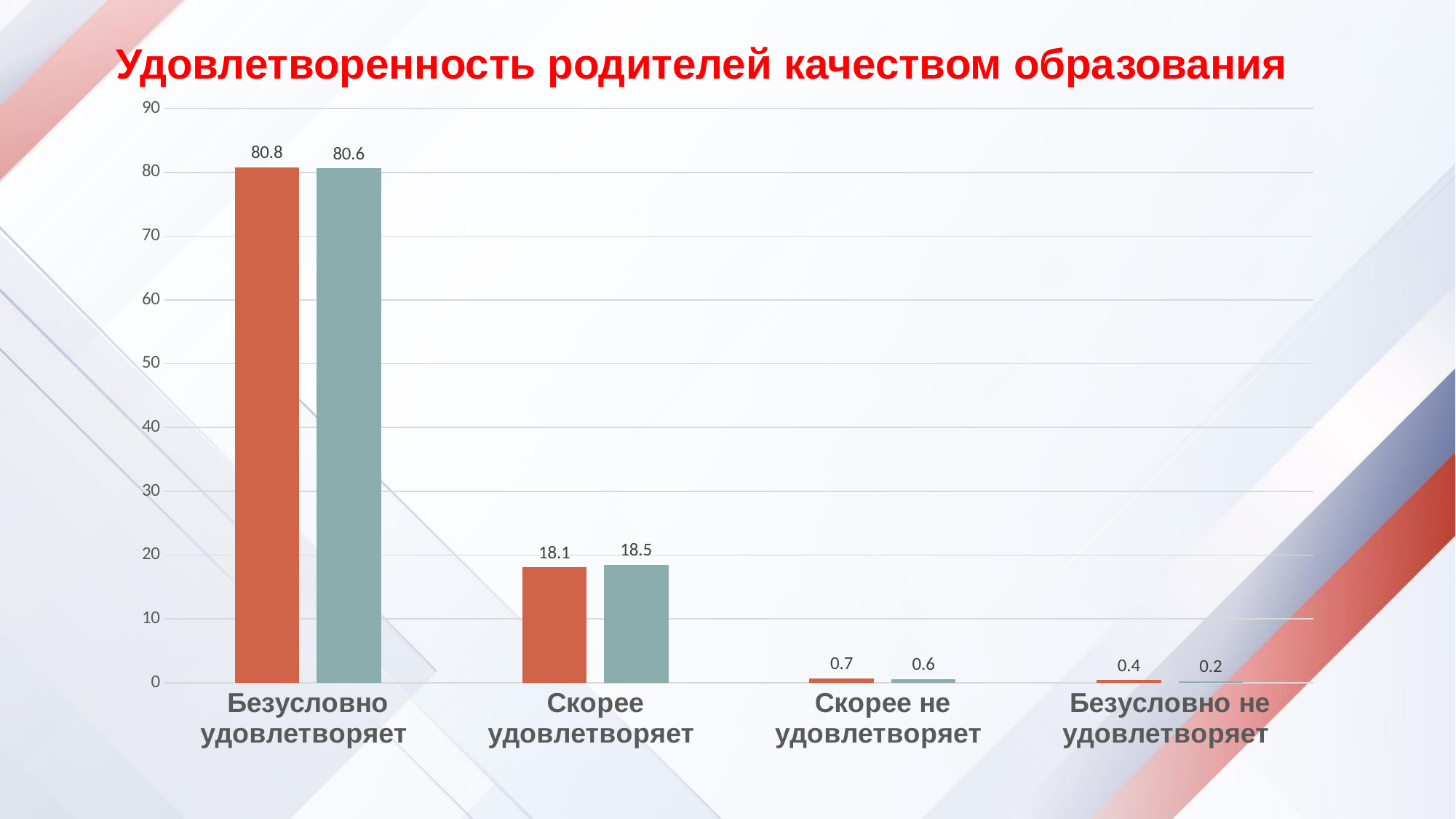
What is the difference between the grey bar (18.5) and the orange bar (18.1) for "Скорее удовлетворяет"? 0.4 How many categories are shown on the x axis? 4 What is the value of the grey bar for "Скорее не удовлетворяет"? 0.6 Do the values rise or fall from left to right along the x axis? fall What is the value of the grey bar for "Безусловно не удовлетворяет"? 0.2 What is the value of the orange bar for "Скорее удовлетворяет"? 18.1 Which category has the lowest values? Безусловно не удовлетворяет What type of chart is shown on the slide? bar chart Which category has the highest values? Безусловно удовлетворяет What is the title of the chart? Удовлетворенность родителей качеством образования What is the value of the grey bar for "Безусловно удовлетворяет"? 80.6 What is the value of the orange bar for "Безусловно удовлетворяет"? 80.8